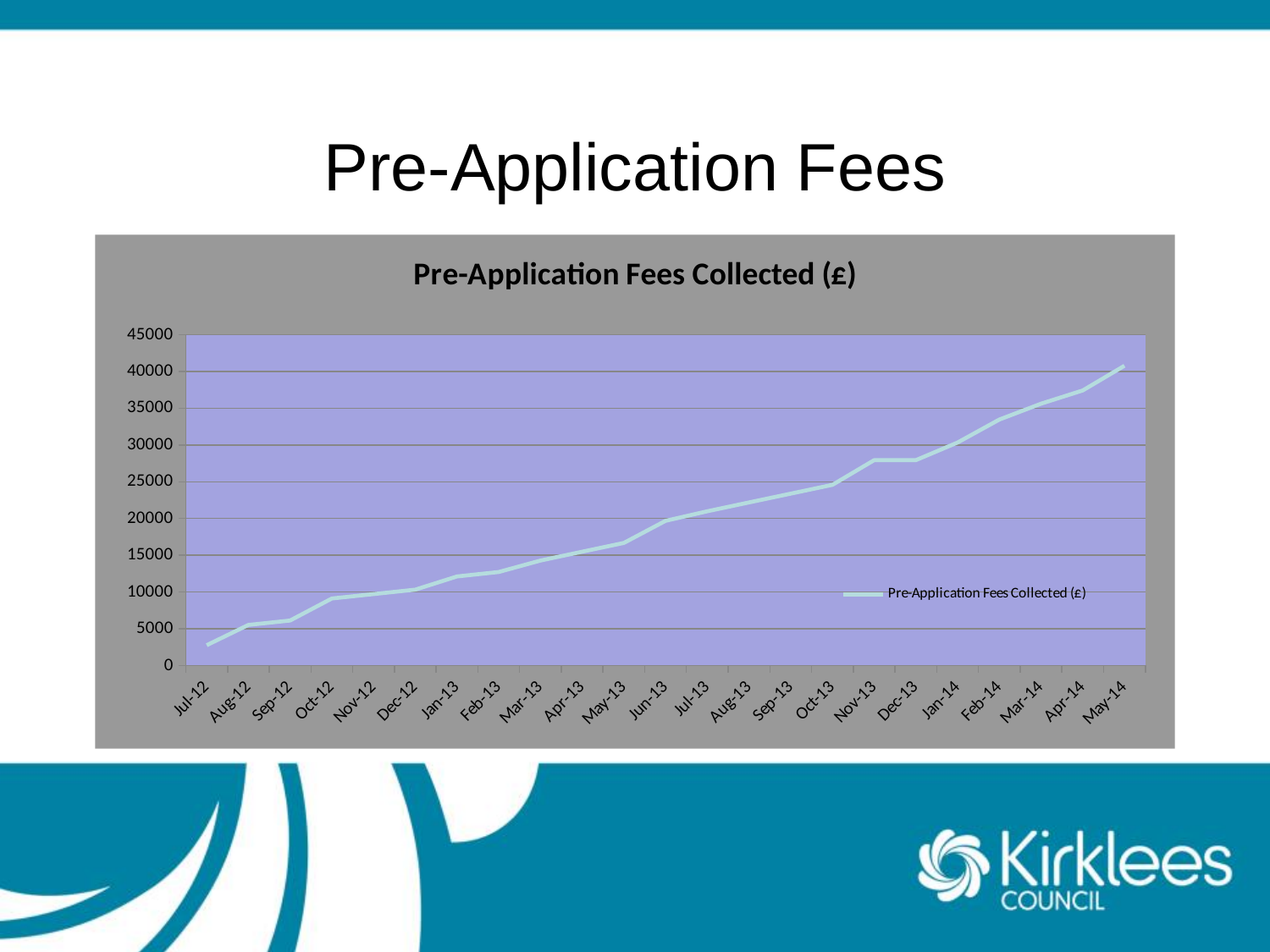
Is the value for Nov-13 greater or less than 25000? greater Which month has the lowest value for Pre-Application Fees Collected? Jul-12 What kind of chart is shown on the slide? line chart How many series does the legend list? 1 Is the value for Jul-12 greater or less than 5000? less What is the title of the chart? Pre-Application Fees Collected (£) Is the value for Oct-12 greater or less than 10000? less Do the values rise or fall from Jul-12 to May-14? rise How many months are plotted along the x axis? 23 Which month has the highest value for Pre-Application Fees Collected? May-14 Which is larger, the value for Jan-14 or the value for Jul-13? Jan-14